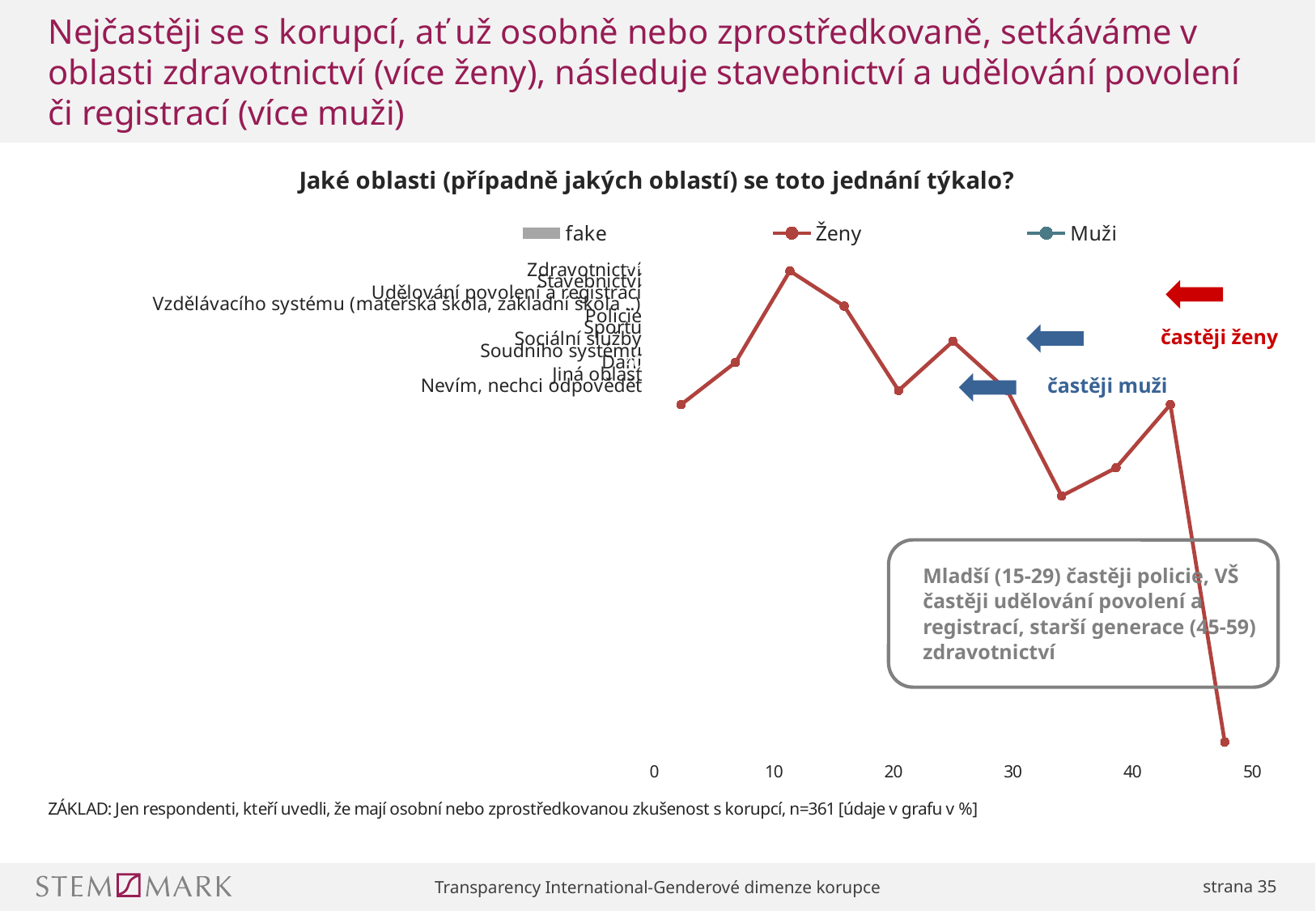
What is the lowest value shown on the chart's numeric axis? 0 How many series does the chart legend list? 3 What is the highest value shown on the chart's numeric axis? 50 How many data points are plotted on the red Ženy line? 11 What is the title of the chart? Jaké oblasti (případně jakých oblastí) se toto jednání týkalo? What are the entries listed in the chart legend? fake, Ženy, Muži What kind of chart is shown on the slide? line chart How many categories are listed on the chart's category axis? 11